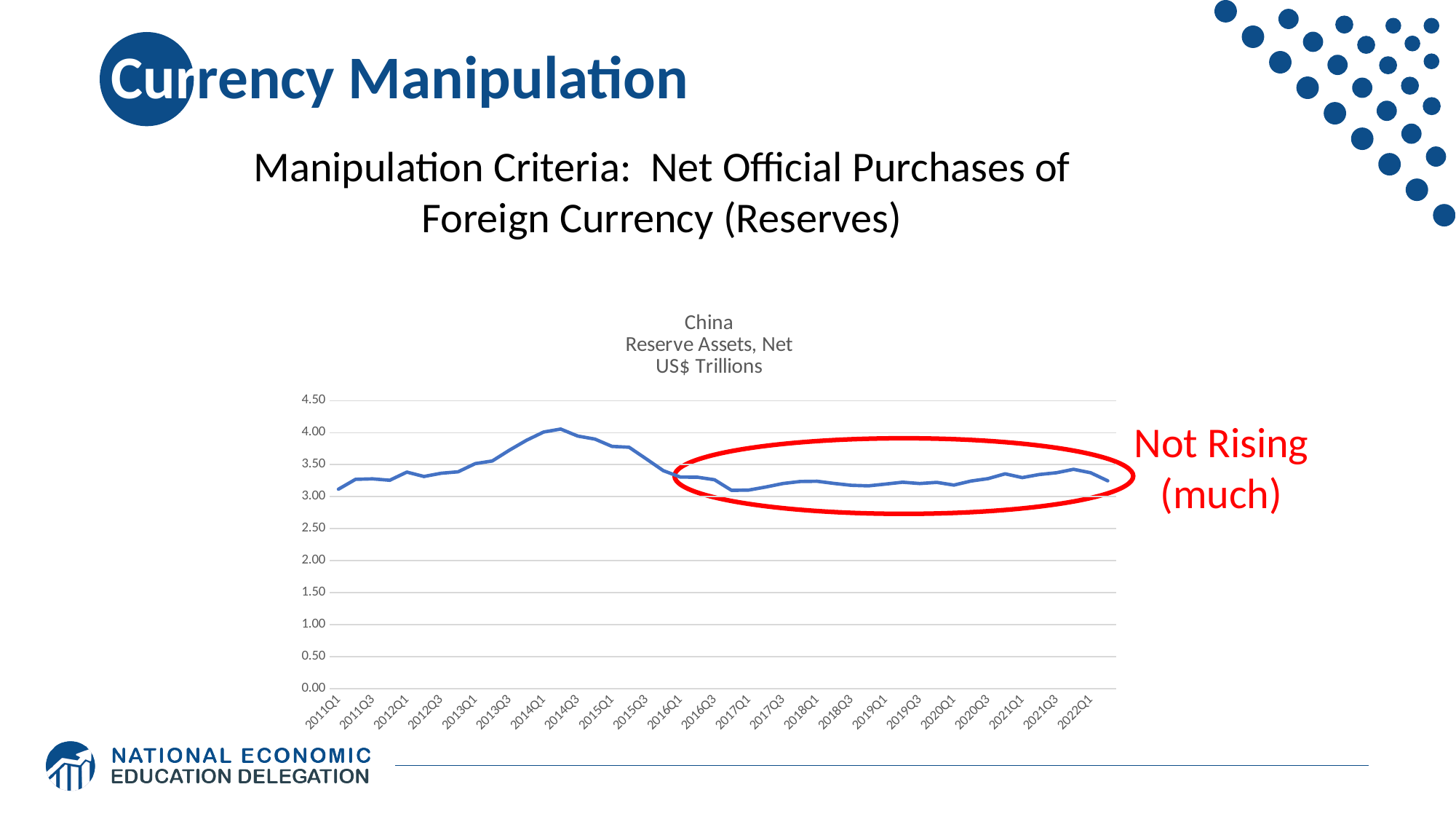
Is the value for 2022Q1 greater or less than 3.00? greater In what units are the values in the chart expressed, according to its title? US$ Trillions Is the value for 2017Q1 greater or less than 3.50? less What kind of chart is shown on the slide? line chart Does the line rise or fall between 2011Q1 and 2014Q3? rise Is the value for 2011Q1 greater or less than 3.50? less What does the red annotation next to the circled part of the line say? Not Rising (much) In which year does the line reach its highest value? 2014 Does the line rise or fall between 2014Q3 and 2017Q1? fall Which is larger, the value for 2014Q3 or the value for 2022Q1? 2014Q3